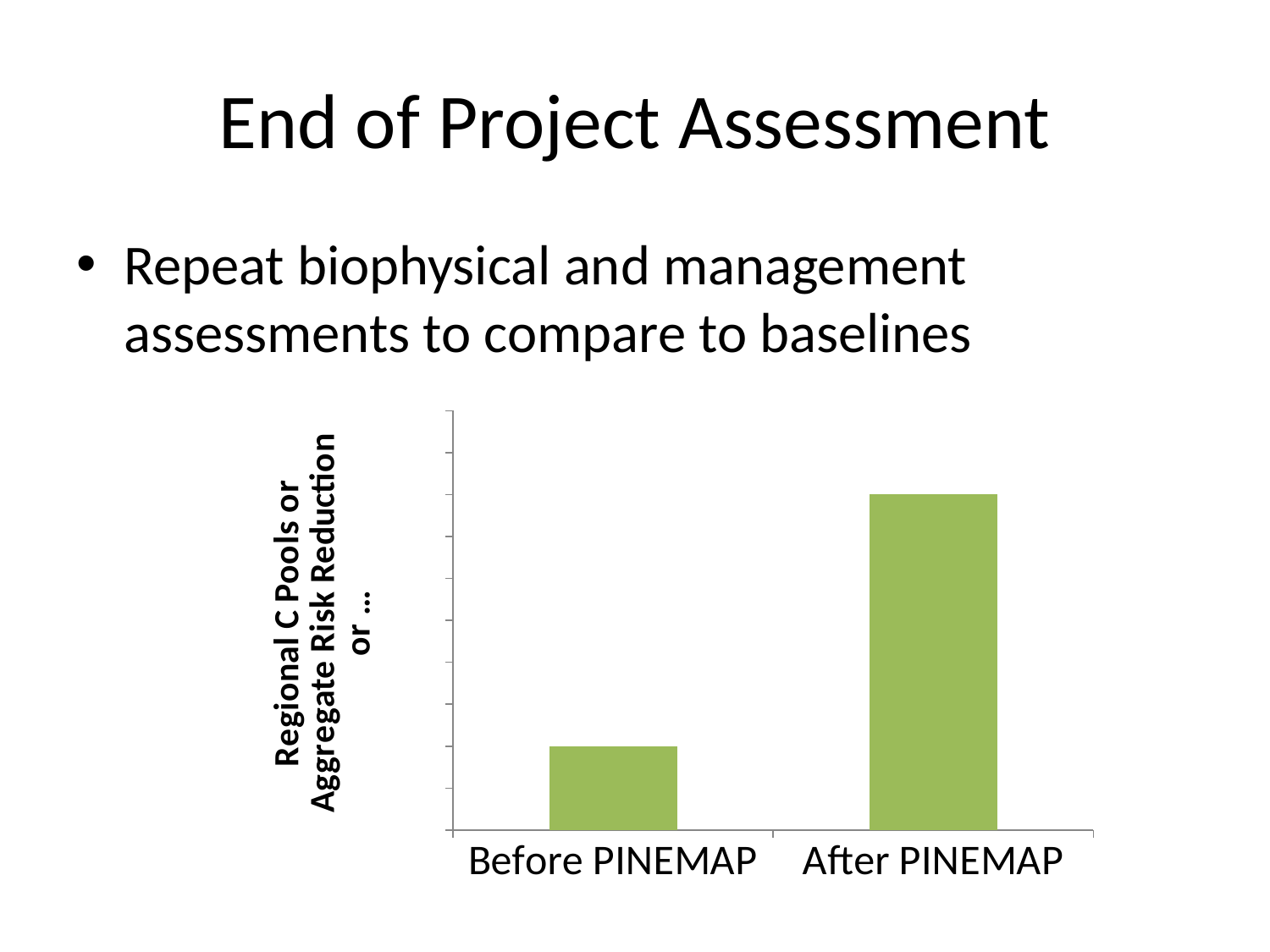
What colour are the bars in the chart? Green Do the bar values rise or fall from Before PINEMAP to After PINEMAP? Rise What is the label on the vertical axis of the chart? Regional C Pools or Aggregate Risk Reduction or ... What kind of chart is shown on the slide? Bar chart What are the two category labels on the x axis of the chart? Before PINEMAP and After PINEMAP Which category has the lowest bar in the chart? Before PINEMAP Which is larger in the chart, the bar for Before PINEMAP or the bar for After PINEMAP? After PINEMAP Which category has the highest bar in the chart? After PINEMAP How many categories are shown on the x axis of the chart? 2